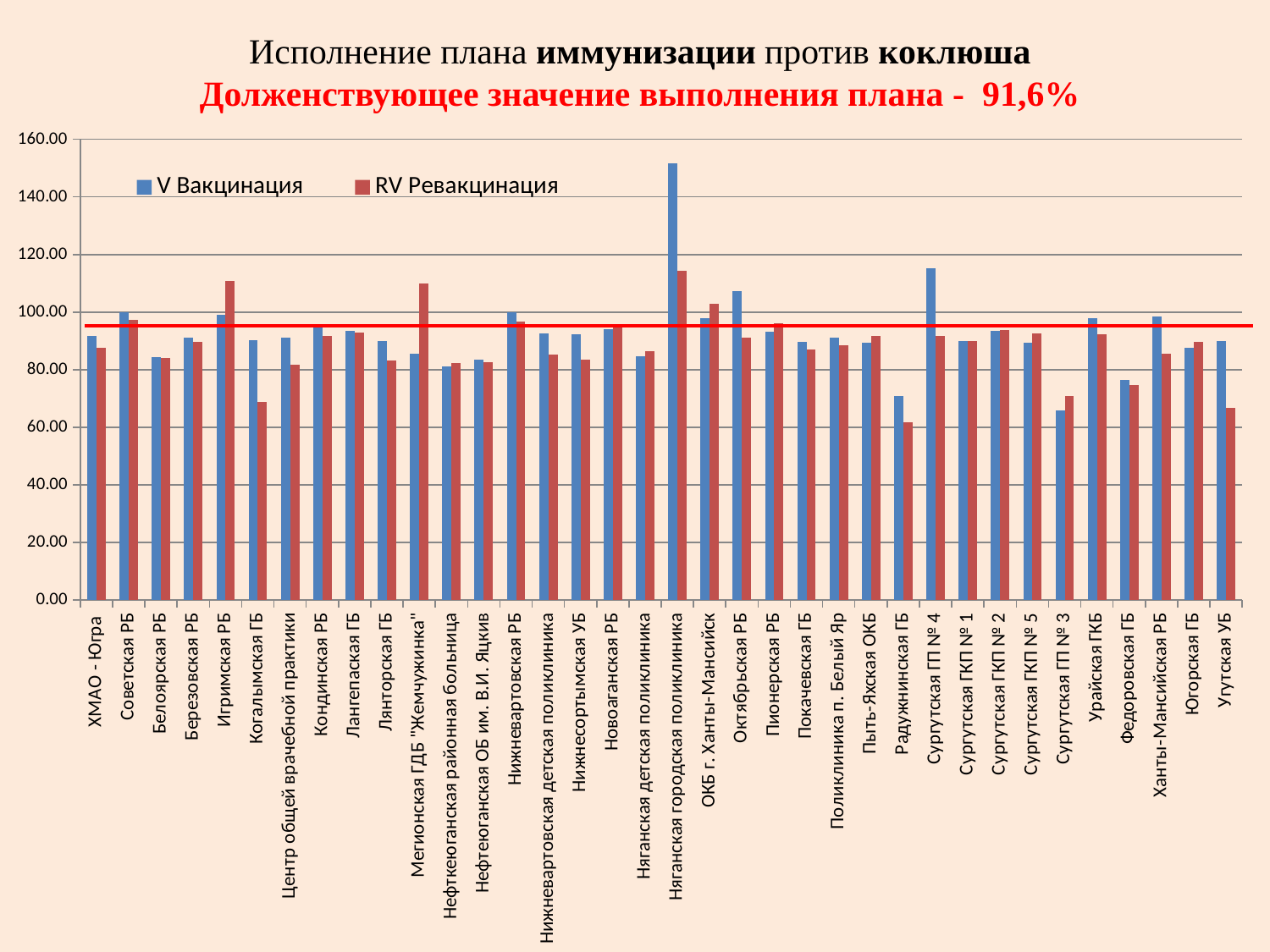
For Мегионская ГДБ "Жемчужинка", which is larger: V Вакцинация or RV Ревакцинация? RV Ревакцинация How many series does the legend list? 2 Is the V Вакцинация value for Радужнинская ГБ greater or less than 80? less How many organisations (categories) are shown along the x axis? 36 Is the V Вакцинация value for Сургутская ГП № 4 greater or less than 100? greater For Игримская РБ, which is larger: V Вакцинация or RV Ревакцинация? RV Ревакцинация Which organisation has the lowest V Вакцинация value? Сургутская ГП № 3 Which organisation has the highest V Вакцинация value? Няганская городская поликлиника What kind of chart is shown on the slide? bar chart Is the RV Ревакцинация value for Когалымская ГБ greater or less than 80? less What target value for plan fulfilment is stated in the slide title? 91,6%